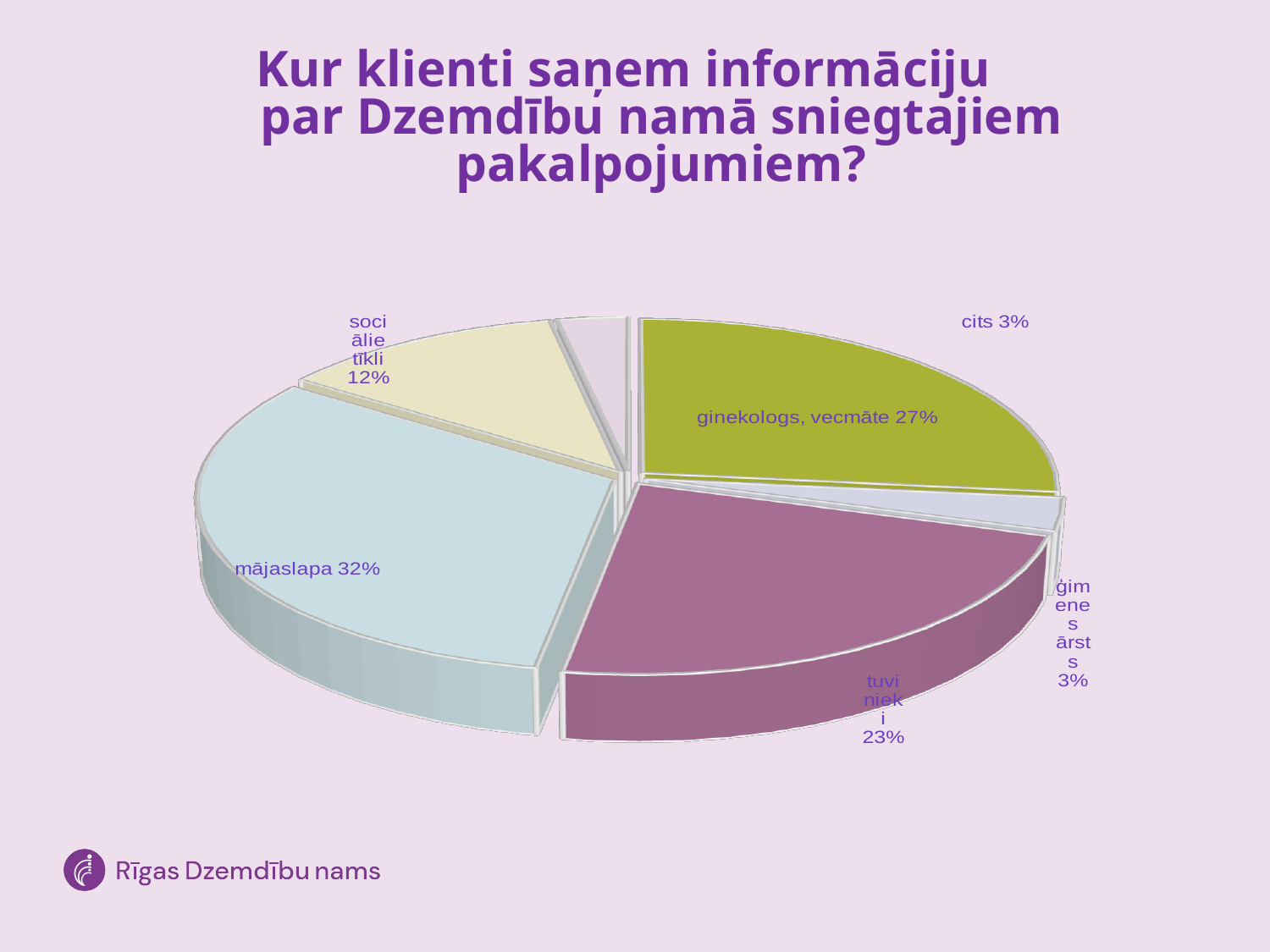
What share of the pie does "cits" have? 3% How many slices does the pie chart have? 6 What share of the pie does "ginekologs, vecmāte" have? 27% What kind of chart is shown on the slide? pie chart What is the difference between the shares of "tuvinieki" and "sociālie tīkli"? 11% What share of the pie does "tuvinieki" have? 23% What is the title of the chart on the slide? Kur klienti saņem informāciju par Dzemdību namā sniegtajiem pakalpojumiem? Which has a larger share, "tuvinieki" or "sociālie tīkli"? tuvinieki Which category has the largest share of the pie? mājaslapa What is the difference between the shares of "mājaslapa" and "ginekologs, vecmāte"? 5%